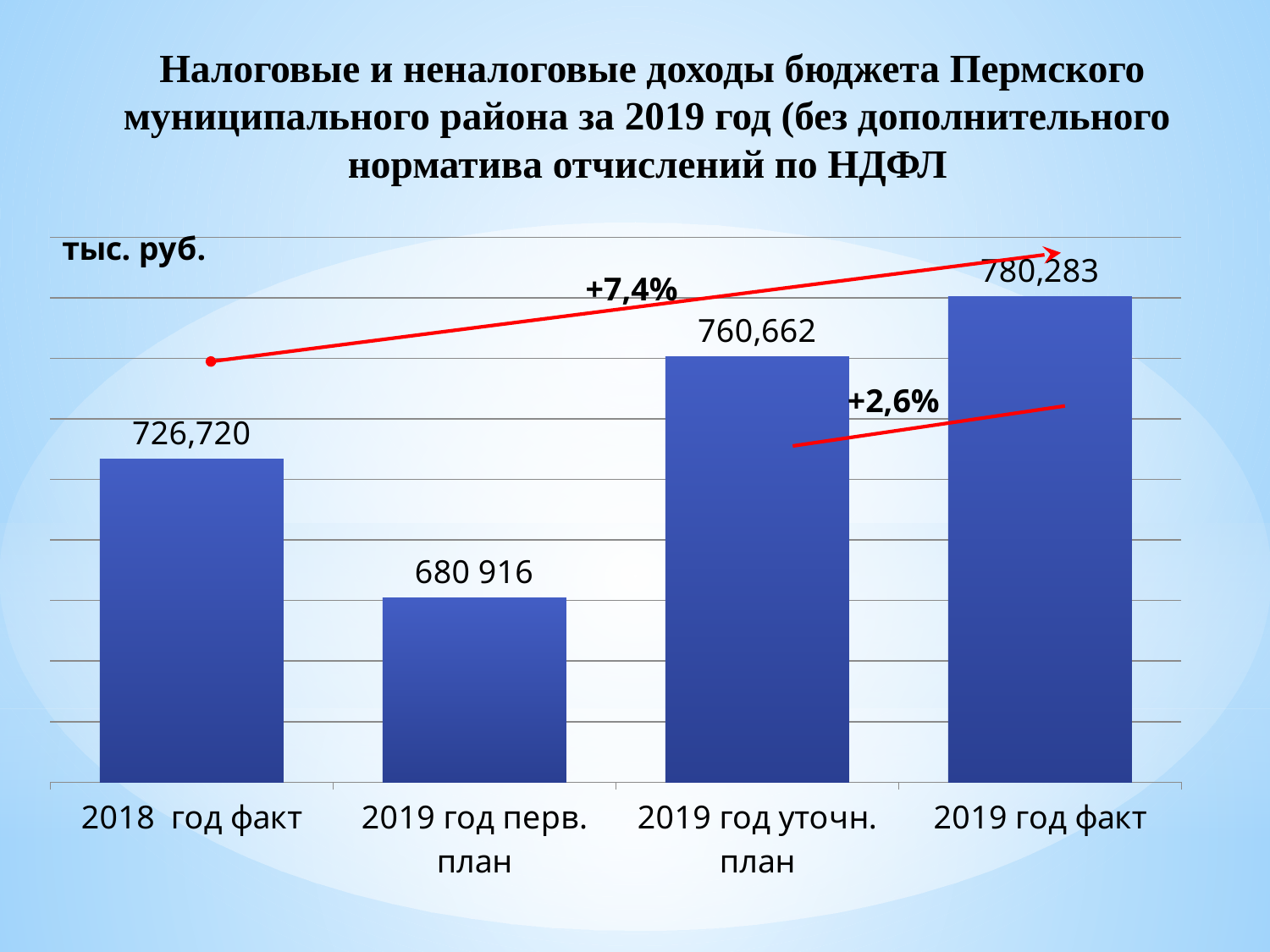
What is the value for 2019 год перв. план? 680 916 What is the value for 2019 год уточн. план? 760,662 Which category has the lowest value? 2019 год перв. план What unit of measurement is indicated in the top-left corner of the chart? тыс. руб. Which is larger, the value for 2018 год факт or the value for 2019 год уточн. план? 2019 год уточн. план What is the value for 2018 год факт? 726,720 What kind of chart is shown on the slide? Bar chart Which category has the highest value? 2019 год факт What is the value for 2019 год факт? 780,283 How many categories are shown on the x axis? 4 What is the difference between the values for 2018 год факт and 2019 год перв. план? 45,804 What is the difference between the values for 2019 год факт and 2019 год уточн. план? 19,621